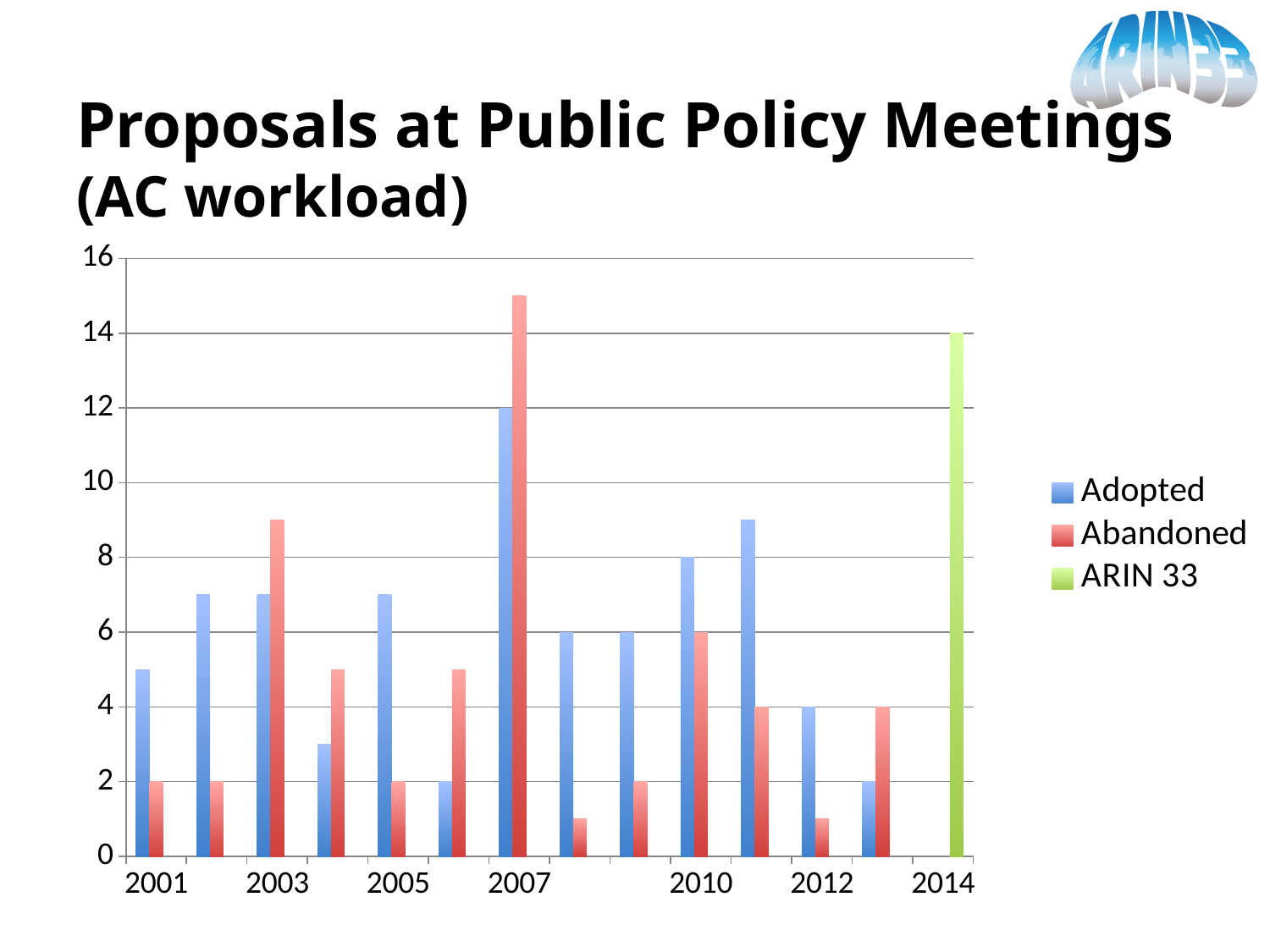
What kind of chart is shown on the slide? bar chart What is the Abandoned value for 2001? 2 Is the Abandoned value for 2007 greater or less than 14? greater What is the ARIN 33 value for 2014? 14 What is the Adopted value for 2012? 4 In 2007, which is larger, the Adopted value or the Abandoned value? Abandoned What is the Adopted value for 2010? 8 What is the difference between the Adopted and Abandoned values for 2010? 2 What is the Abandoned value for 2010? 6 How many series does the legend list? 3 What is the Adopted value for 2007? 12 Which year has the highest Abandoned value? 2007